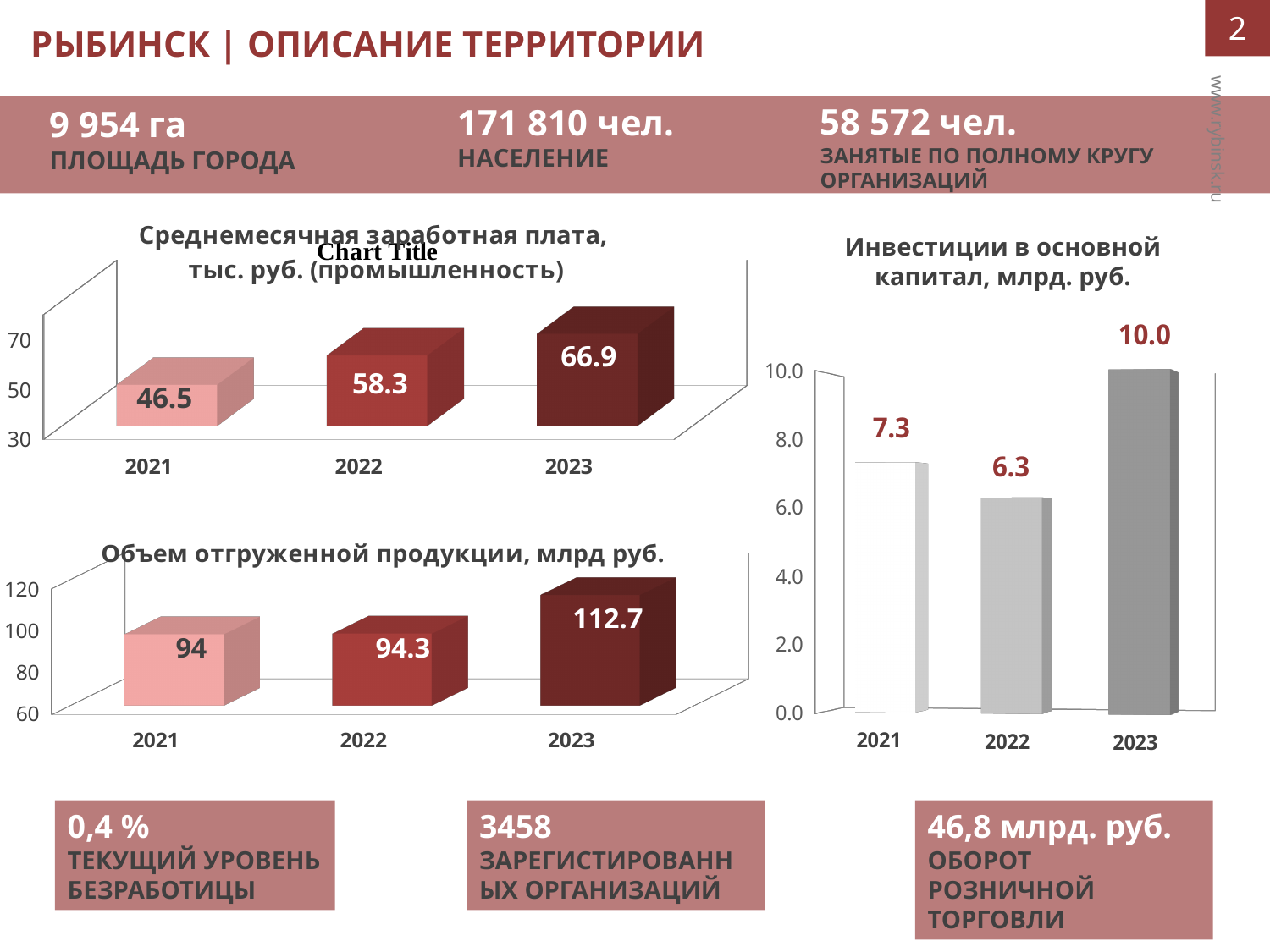
In the chart 'Среднемесячная заработная плата, тыс. руб. (промышленность)', which year has the highest value? 2023 How many years are shown in the chart 'Инвестиции в основной капитал, млрд. руб.'? 3 In the chart 'Среднемесячная заработная плата, тыс. руб. (промышленность)', what is the value for 2022? 58.3 In the chart 'Среднемесячная заработная плата, тыс. руб. (промышленность)', do the values rise or fall from 2021 to 2023? rise In the chart 'Инвестиции в основной капитал, млрд. руб.', which is larger, the value for 2021 or 2022? 2021 In the chart 'Объем отгруженной продукции, млрд руб.', what is the value for 2023? 112.7 In the chart 'Объем отгруженной продукции, млрд руб.', which year has the lowest value? 2021 In the chart 'Инвестиции в основной капитал, млрд. руб.', which year has the lowest value? 2022 What type of chart is 'Инвестиции в основной капитал, млрд. руб.'? bar chart In the chart 'Объем отгруженной продукции, млрд руб.', what is the difference between the 2023 and 2022 values? 18.4 In the chart 'Среднемесячная заработная плата, тыс. руб. (промышленность)', what is the difference between the 2023 and 2021 values? 20.4 In the chart 'Инвестиции в основной капитал, млрд. руб.', what is the value for 2021? 7.3